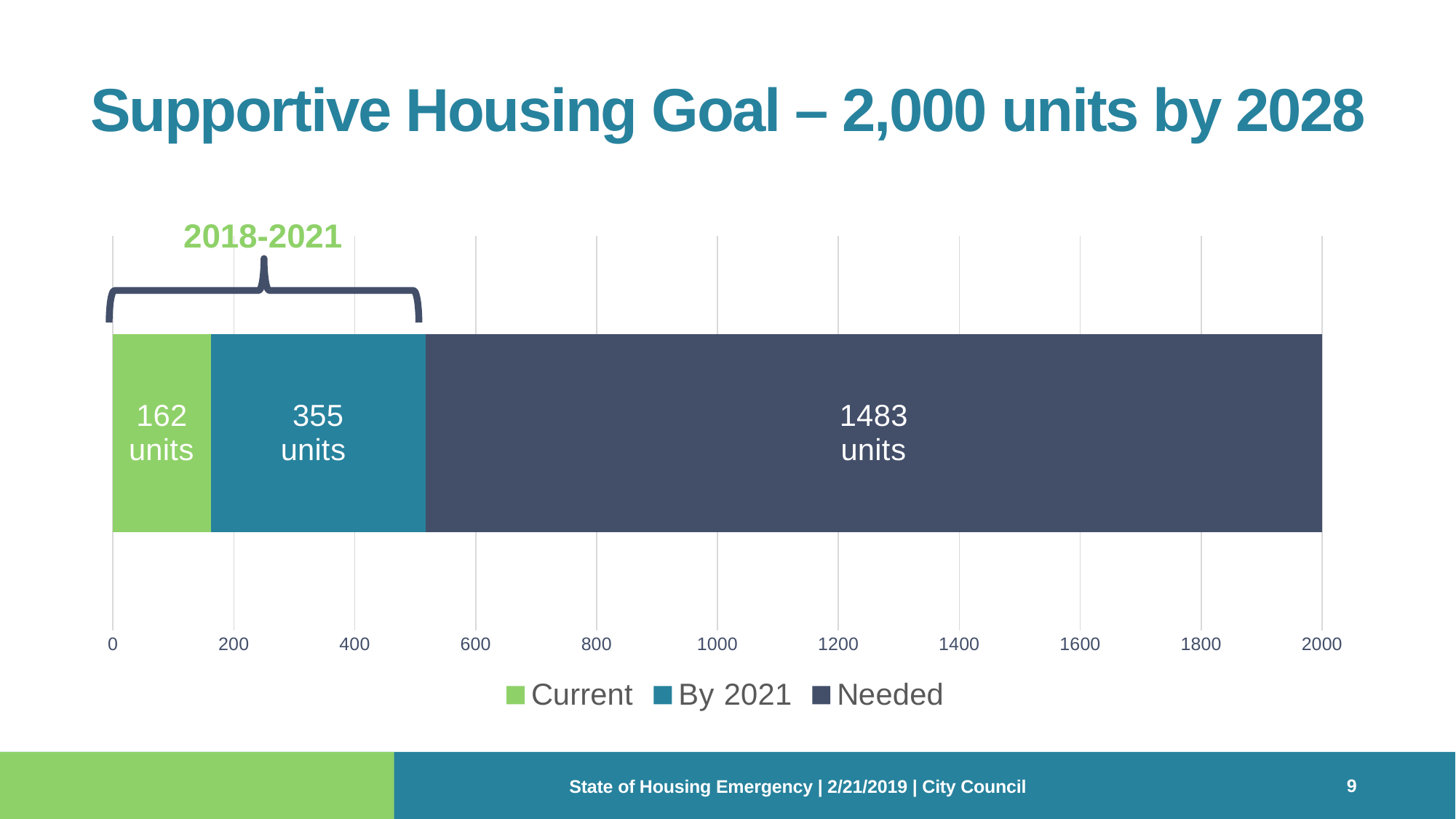
What kind of chart is shown on the slide? Stacked bar chart What is the value of the Needed segment? 1483 units What is the difference between the Needed and By 2021 values? 1128 units Which series has the largest value? Needed Which series is shown in green? Current Is the Needed value greater or less than 1400? greater What is the total of the stacked bar? 2000 units Which series has the smallest value? Current What is the value of the By 2021 segment? 355 units Which is larger, the Current value or the By 2021 value? By 2021 How many series does the legend list? 3 What is the value of the Current segment? 162 units